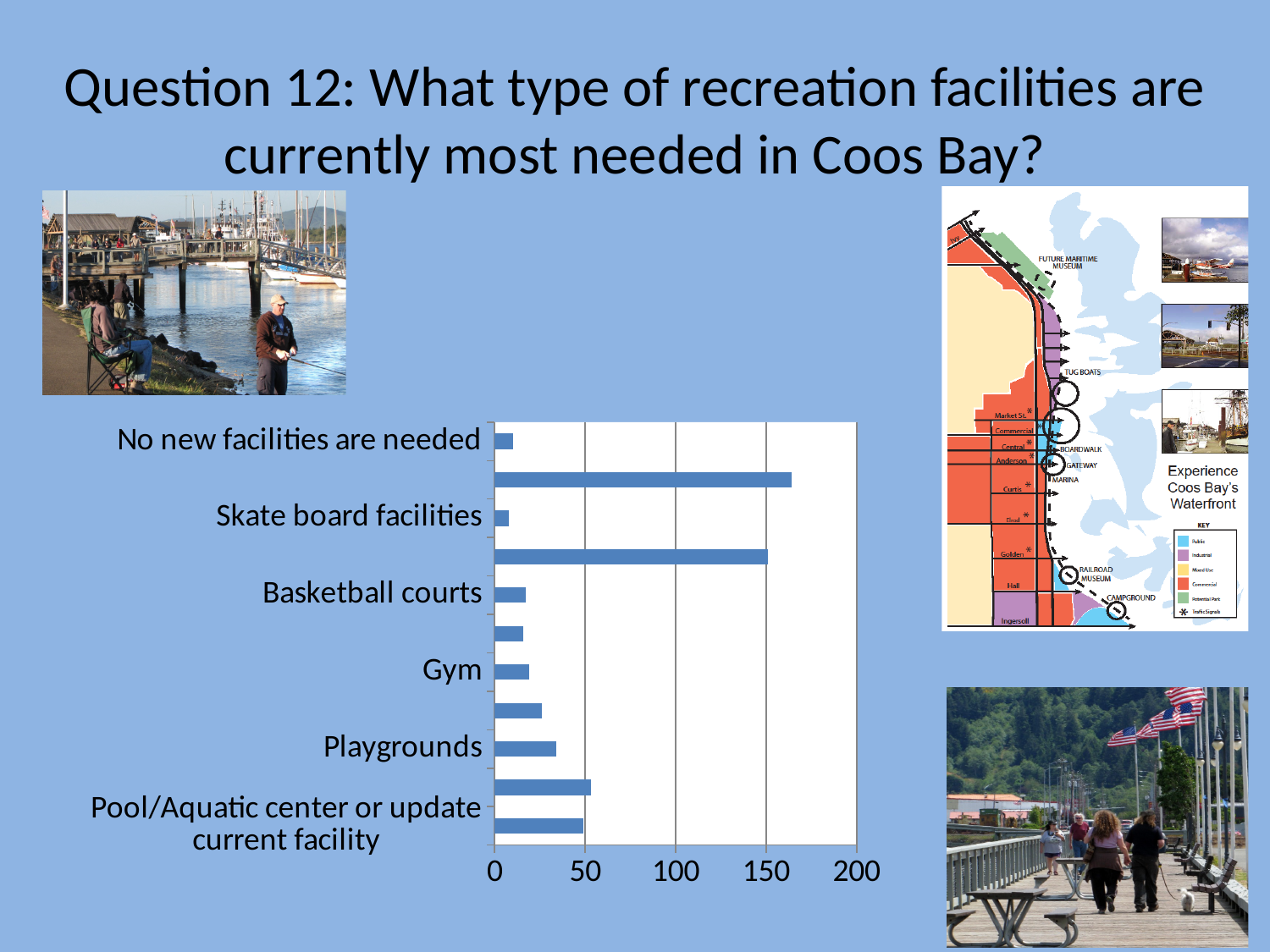
Is the value for Gym greater or less than 50? less Is the value for Basketball courts greater or less than 50? less Which is larger, the value for Playgrounds or the value for Basketball courts? Playgrounds Is the value for Skate board facilities greater or less than 50? less Which is larger, the value for Pool/Aquatic center or update current facility or the value for Gym? Pool/Aquatic center or update current facility Which is larger, the value for Pool/Aquatic center or update current facility or the value for Playgrounds? Pool/Aquatic center or update current facility What is the highest value shown on the chart's horizontal axis? 200 How many bars does the chart contain? 11 What kind of chart is shown on the slide? bar chart